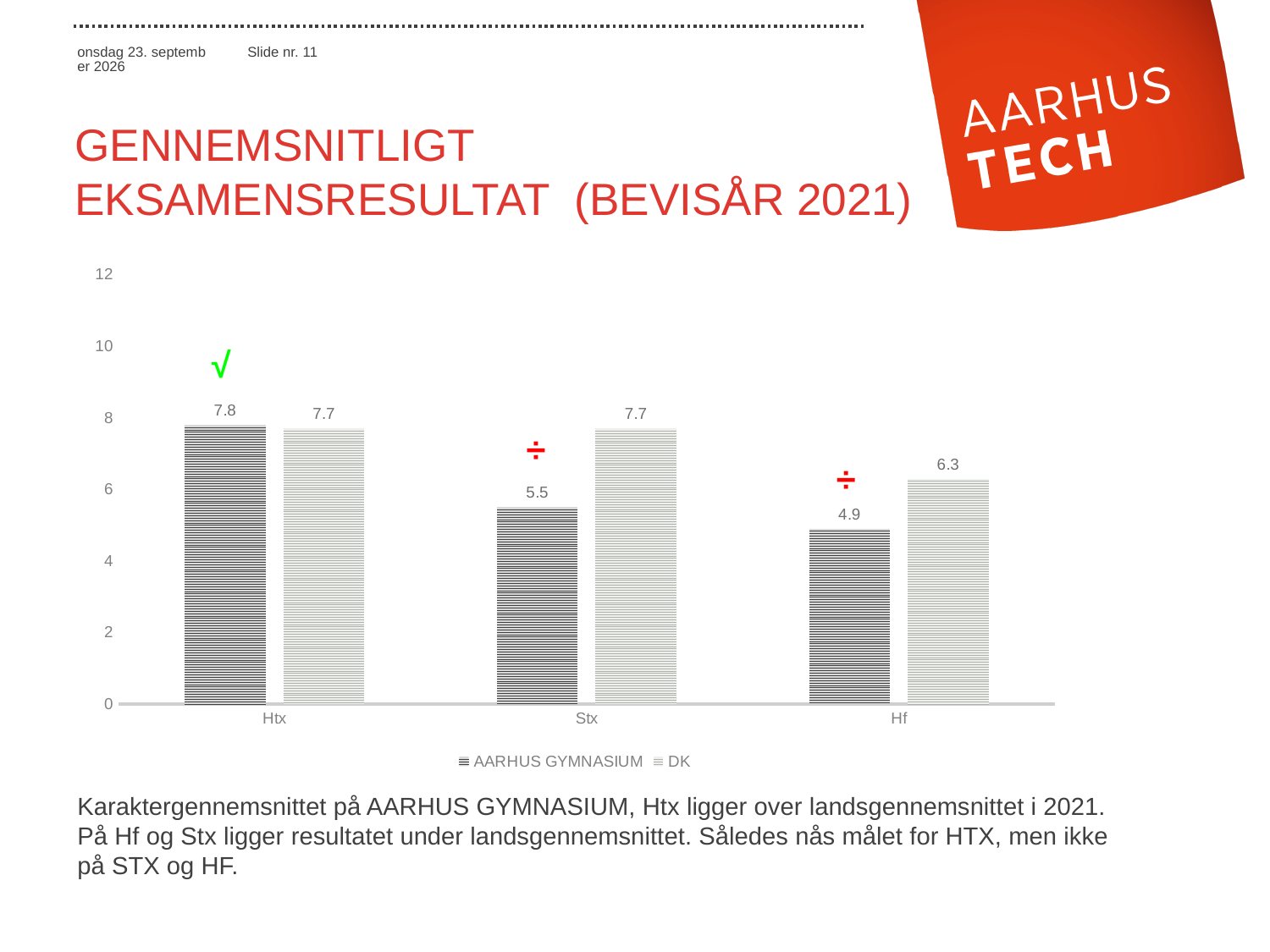
Is the AARHUS GYMNASIUM value for Stx greater or less than 6? less What is the value for DK in the Hf category? 6.3 What is the value for AARHUS GYMNASIUM in the Htx category? 7.8 Which is larger in the Hf category: AARHUS GYMNASIUM or DK? DK What is the difference between the DK value and the AARHUS GYMNASIUM value in the Stx category? 2.2 Which category has the highest value for DK? Htx and Stx (tied at 7.7) What kind of chart is shown on the slide? bar chart What is the value for AARHUS GYMNASIUM in the Hf category? 4.9 How many series does the legend list? 2 What is the value for DK in the Stx category? 7.7 Which category has the lowest value for AARHUS GYMNASIUM? Hf How many categories are shown on the x axis? 3